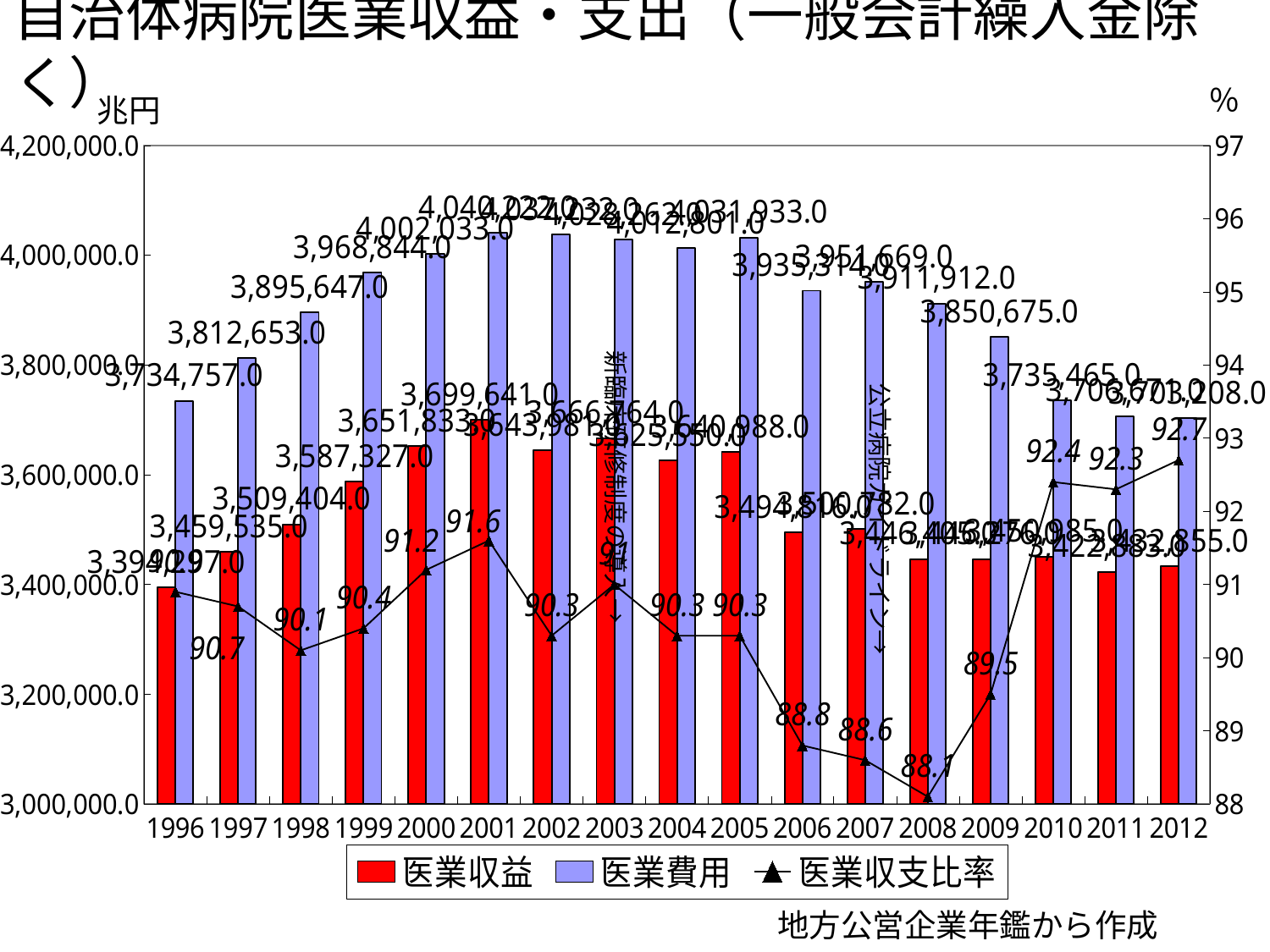
What is the value of 医業費用 in 1997? 3,812,653.0 What is the difference between 医業費用 in 1998 and in 1997? 82,994.0 What is the 医業収支比率 value in 2008? 88.1 In which year is the 医業収支比率 lowest? 2008 Which is larger, 医業費用 in 2004 or in 2009? 2004 How many series does the legend list? 3 How many years are shown on the x axis? 17 In which year is the 医業収支比率 highest? 2012 What kind of chart is shown on the slide? A combined bar and line chart Is the value of 医業収益 in 2006 greater or less than 3,600,000.0? less What is the value of 医業収益 in 1999? 3,587,327.0 What is the value of 医業費用 in 2004? 4,012,801.0